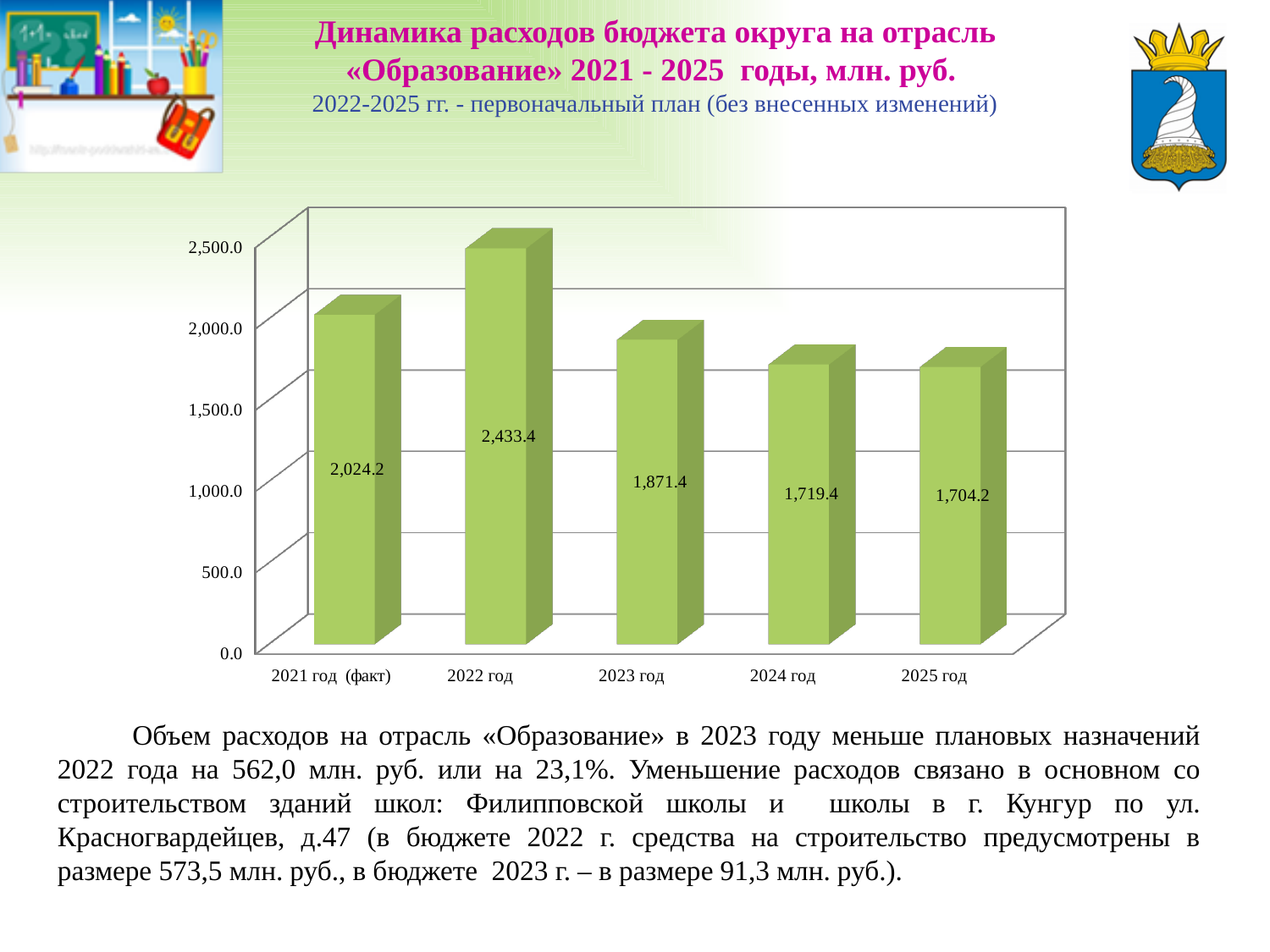
What is the value for 2021 год (факт)? 2,024.2 What is the value for 2025 год? 1,704.2 How many years are shown on the chart? 5 What is the value for 2022 год? 2,433.4 What is the difference between the values for 2024 год and 2025 год? 15.2 Is the value for 2023 год greater or less than 2,000.0? less What kind of chart is shown on the slide? bar chart Which year has the highest value? 2022 год Which is larger, the value for 2021 год (факт) or the value for 2023 год? 2021 год (факт) What is the difference between the values for 2022 год and 2023 год? 562.0 Which year has the lowest value? 2025 год Do the values rise or fall from 2022 год to 2025 год? fall